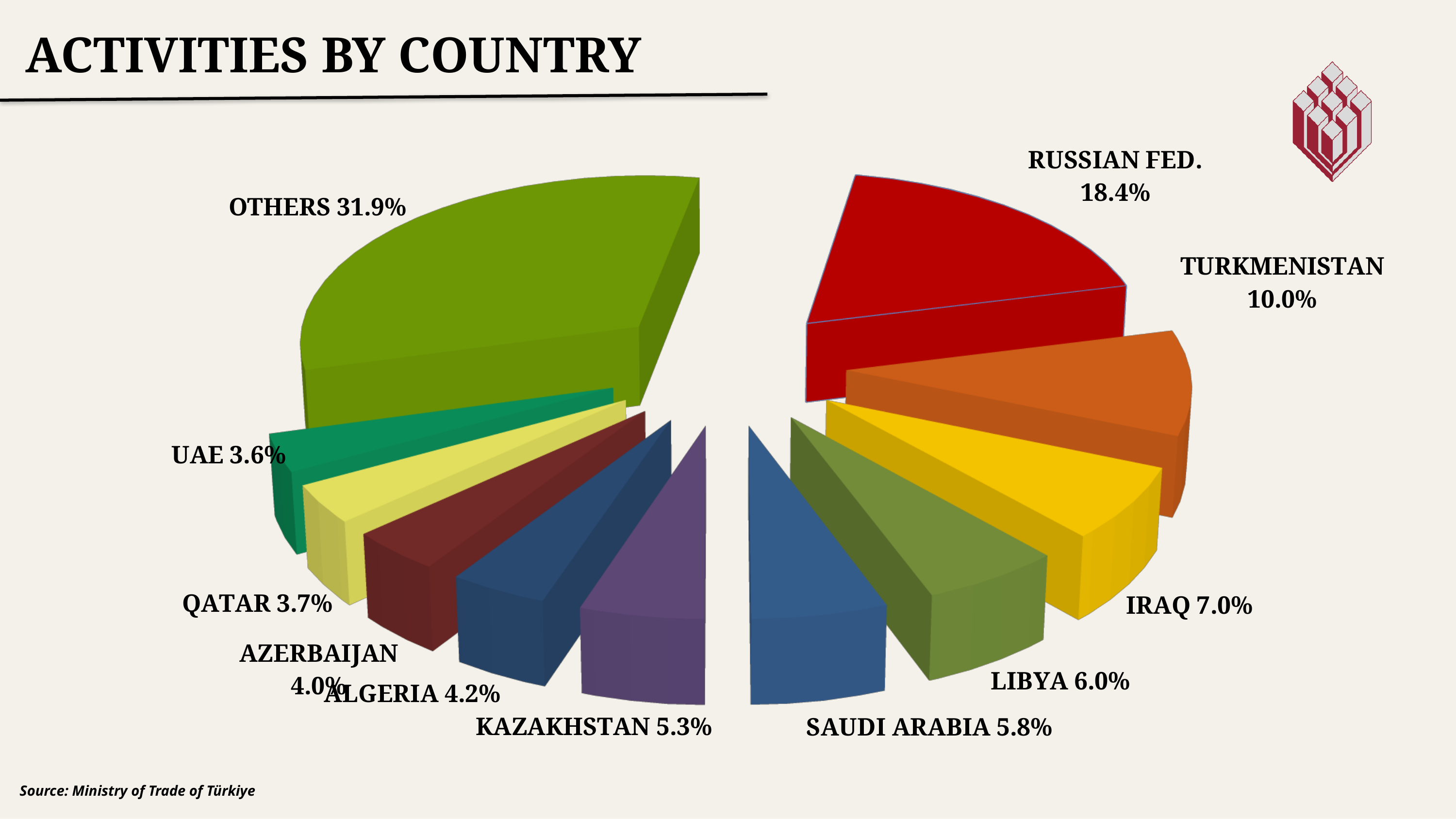
What is the share for Turkmenistan? 10.0% What is the difference between the shares of Russian Fed. and Turkmenistan? 8.4% Which slice has the largest share? Others What is the share for Kazakhstan? 5.3% Which slice has the smallest share? UAE What kind of chart is shown on the slide? Pie chart Which has a larger share, Iraq or Libya? Iraq What is the share for Libya? 6.0% What is the share for Russian Fed.? 18.4% What is the title of the chart? ACTIVITIES BY COUNTRY Which named country (excluding Others) has the largest share? Russian Fed. How many slices does the pie chart have? 11